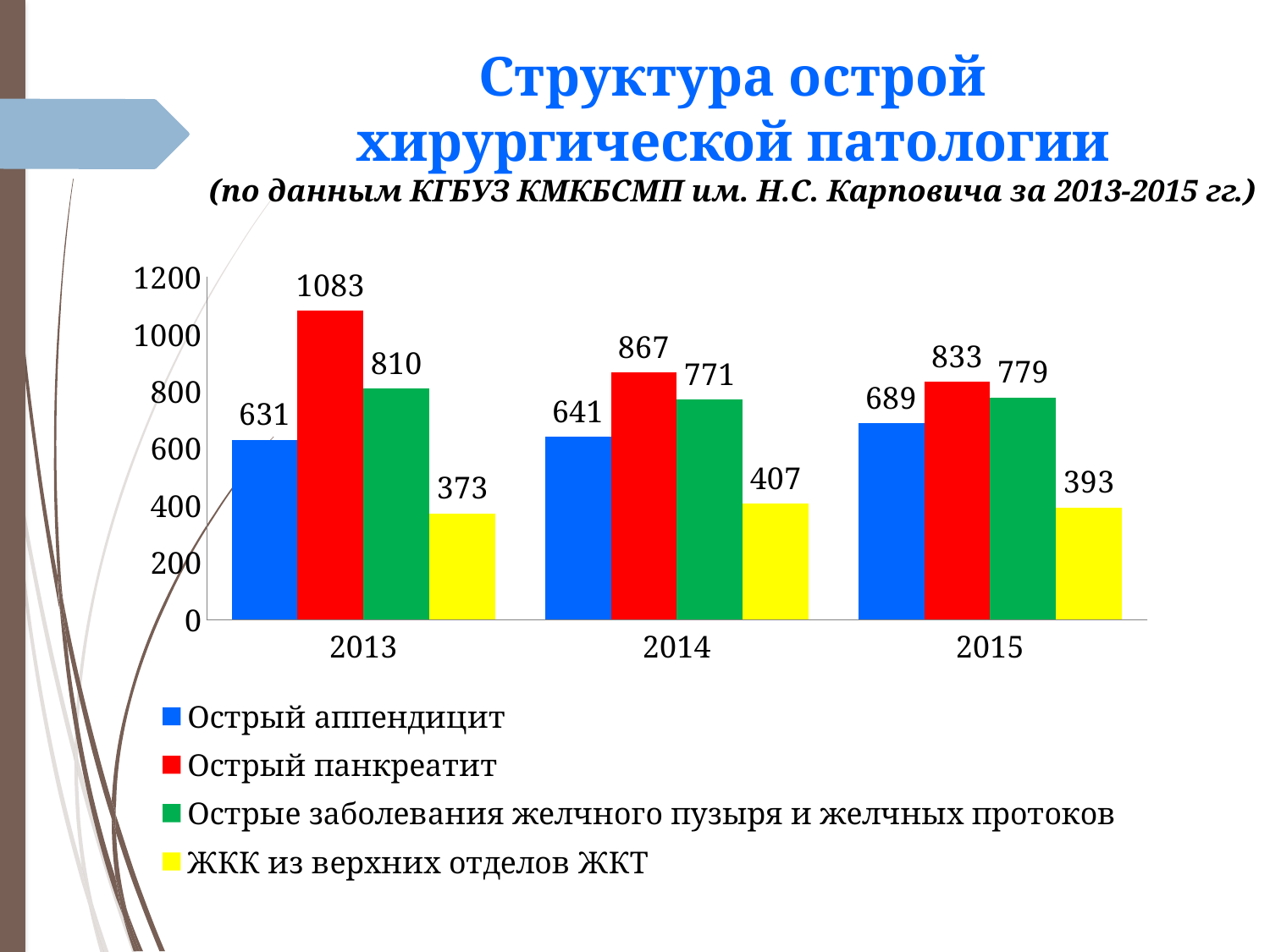
How many series does the legend list? 4 Does the value for Острый аппендицит rise or fall from 2013 to 2015? Rises Which year has the highest value for Острый панкреатит? 2013 Which is larger: Острые заболевания желчного пузыря и желчных протоков in 2013 or in 2015? 2013 What is the value for ЖКК из верхних отделов ЖКТ in 2014? 407 Which colour represents Острый панкреатит in the legend? Red What is the difference between the Острый панкреатит values in 2013 and 2014? 216 What kind of chart is shown on the slide? Bar chart What is the value for Острый панкреатит in 2013? 1083 What is the value for Острый аппендицит in 2015? 689 How many years are shown on the x axis? 3 Which series has the lowest value in 2015? ЖКК из верхних отделов ЖКТ